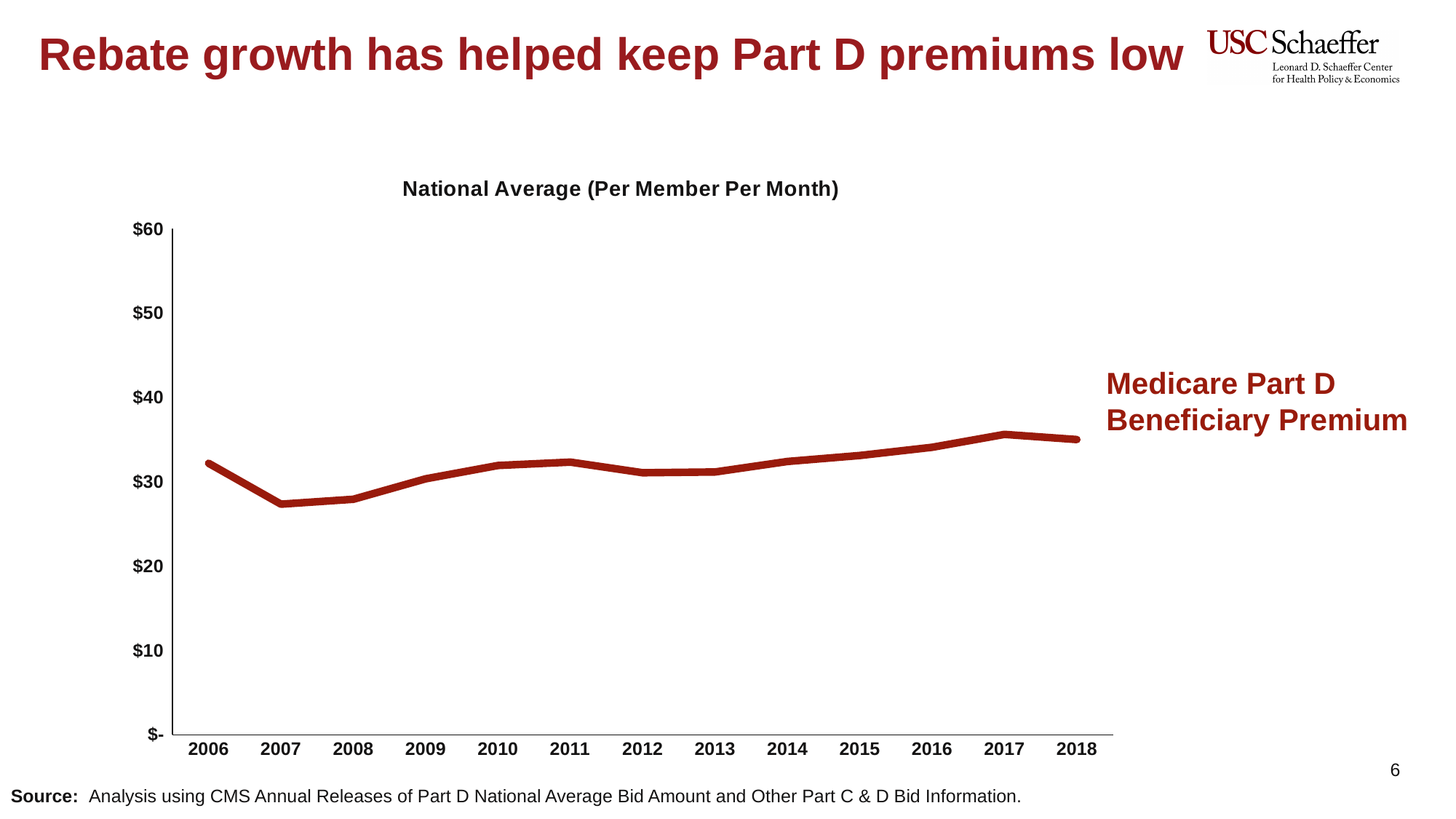
Which is larger, the value for 2006 or the value for 2007? 2006 Is the value for 2006 greater or less than $30? greater Is the value for 2017 greater or less than $40? less How many years are plotted along the x axis? 13 Is the value for 2007 greater or less than $30? less Which year has the lowest Medicare Part D Beneficiary Premium? 2007 Which is larger, the value for 2008 or the value for 2017? 2017 What is the title of the chart? National Average (Per Member Per Month) Does the Medicare Part D Beneficiary Premium rise or fall from 2013 to 2017? rise What series does the line on the chart represent? Medicare Part D Beneficiary Premium What kind of chart is shown on the slide? line chart